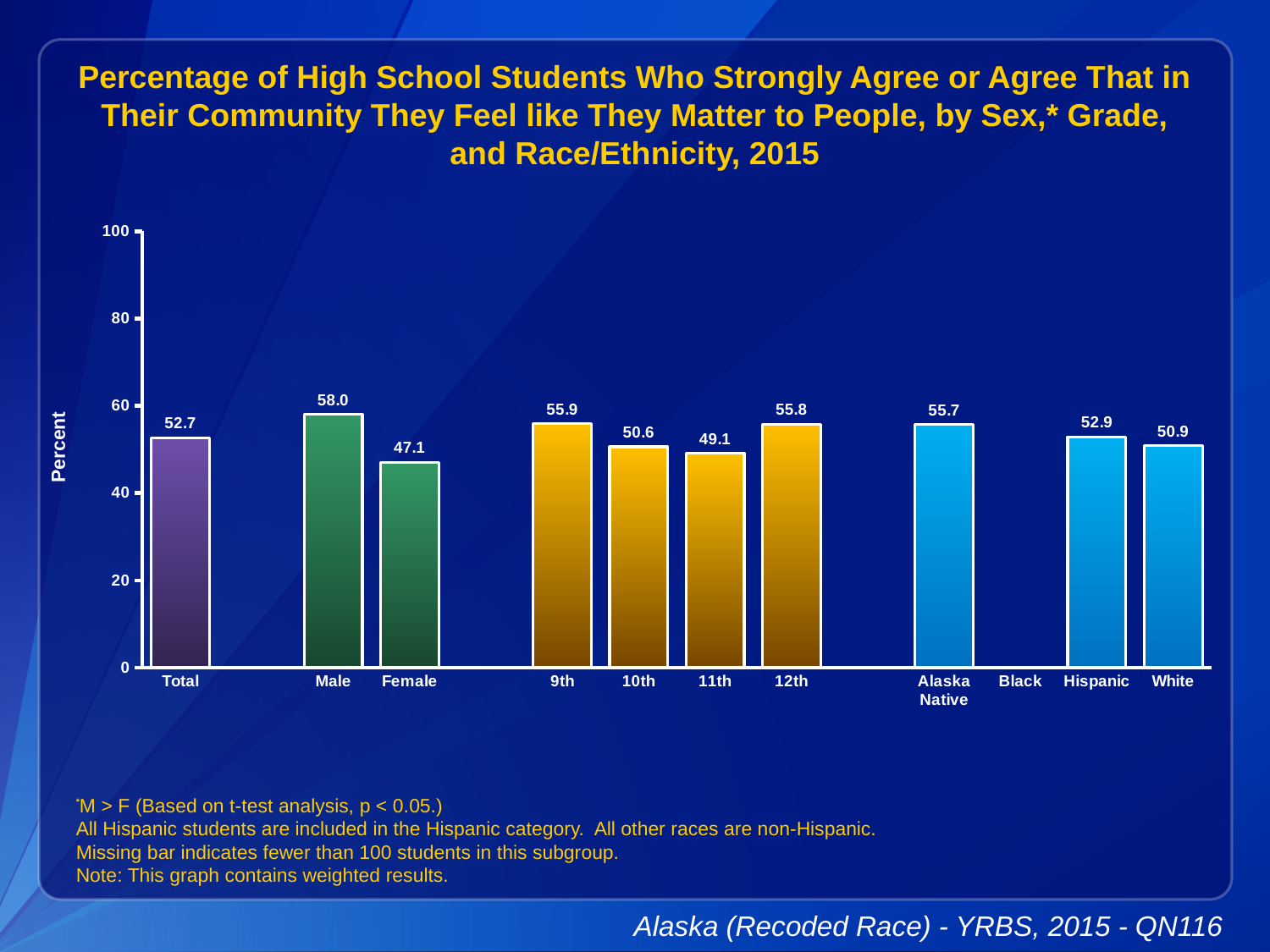
What is the value for Male? 58.0 Which category has the highest value? Male What is the value for Female? 47.1 What is the value for Alaska Native? 55.7 Which category has the lowest value among the bars shown? Female Is the value for Total greater or less than 60? less What is the difference between the Male and Female values? 10.9 What is the value for 11th grade? 49.1 What kind of chart is shown on the slide? bar chart Which is larger, the value for 9th grade or the value for 10th grade? 9th How many categories have a bar plotted on the chart? 11 Which category on the x axis has no bar plotted? Black